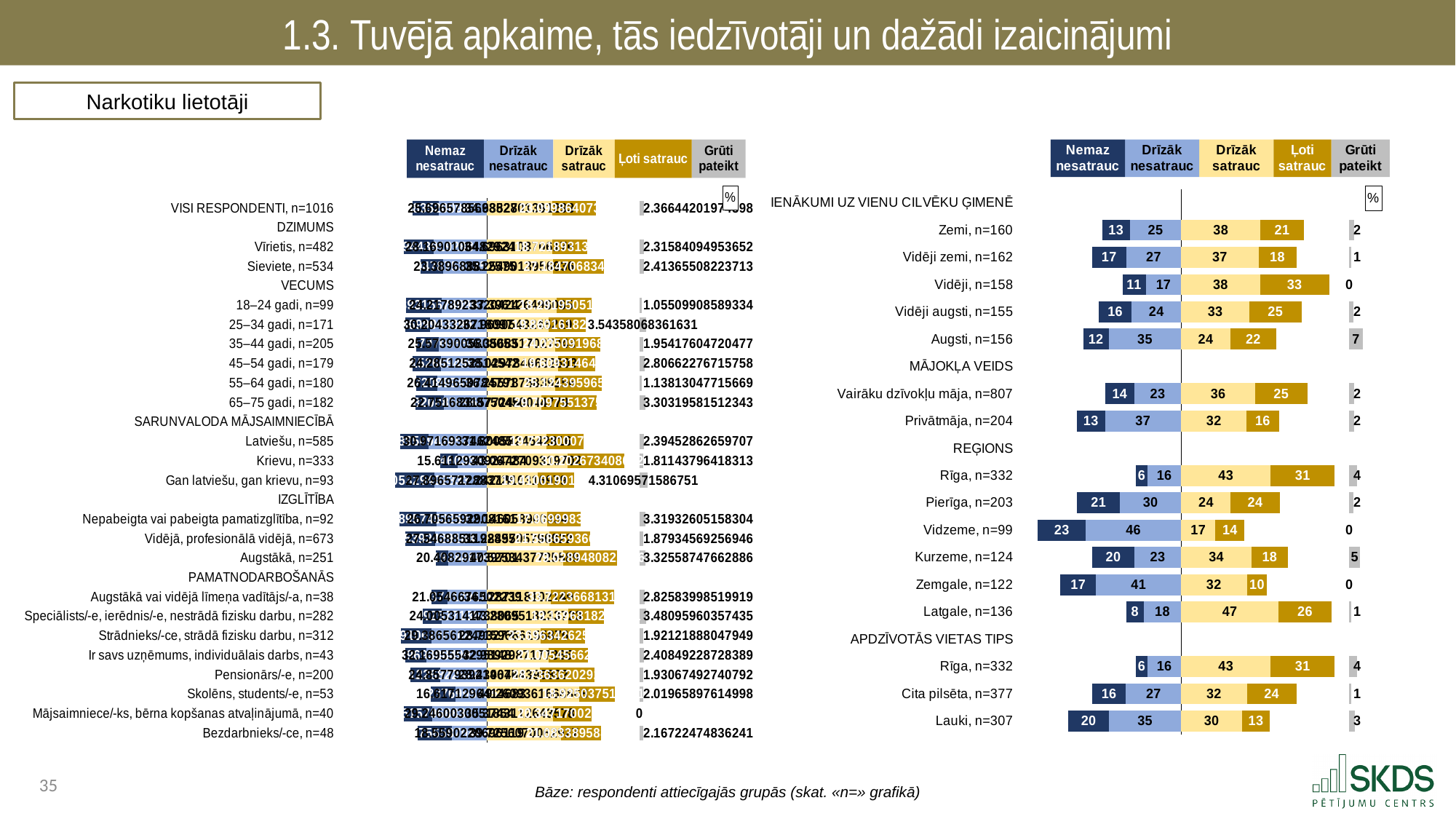
How many series does the legend of the right-hand chart list? 5 In the right-hand chart, what is the 'Drīzāk satrauc' value for Latgale, n=136? 47 In the right-hand chart, what is the 'Grūti pateikt' value for Augsti, n=156? 7 In the right-hand chart, how many income groups are listed under IENĀKUMI UZ VIENU CILVĒKU ĢIMENĒ? 5 In the right-hand chart, which region (REĢIONS) has the highest 'Drīzāk satrauc' value? Latgale, n=136 In the right-hand chart, which income group (IENĀKUMI UZ VIENU CILVĒKU ĢIMENĒ) has the highest 'Ļoti satrauc' value? Vidēji, n=158 In the right-hand chart, what is the 'Ļoti satrauc' value for Lauki, n=307? 13 In the right-hand chart, which region (REĢIONS) has the lowest 'Nemaz nesatrauc' value? Rīga, n=332 In the right-hand chart, which legend entry is shown in dark gold colour? Ļoti satrauc What kind of chart is the right-hand chart? Stacked bar chart In the right-hand chart, which has the larger 'Drīzāk nesatrauc' value: Privātmāja, n=204 or Vairāku dzīvokļu māja, n=807? Privātmāja, n=204 In the right-hand chart, what is the difference between the 'Drīzāk nesatrauc' values for Vidzeme, n=99 and Zemgale, n=122? 5